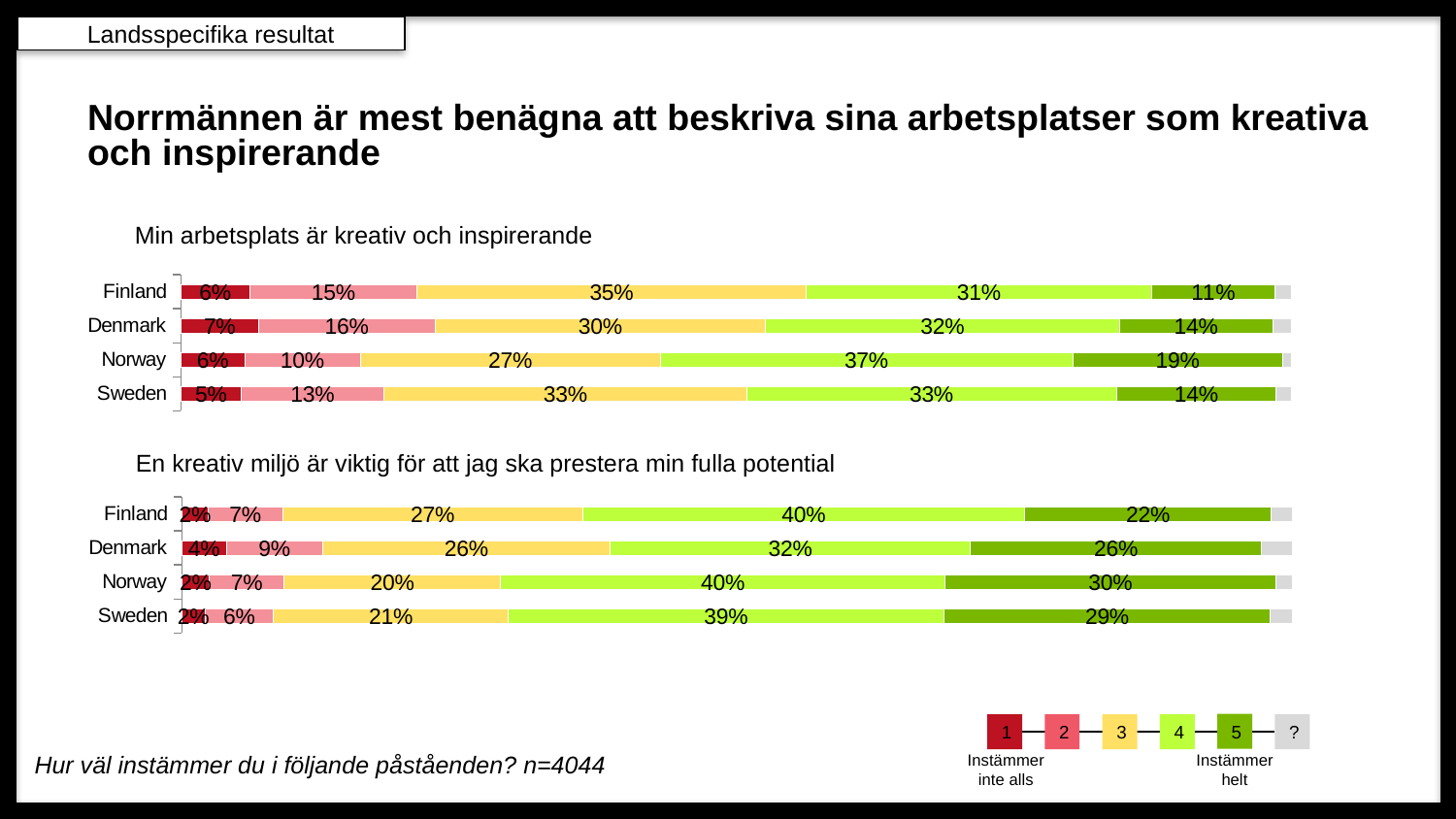
In the chart 'En kreativ miljö är viktig för att jag ska prestera min fulla potential', what is the difference between Sweden's and Denmark's share answering 4? 7% What type of chart is used for 'En kreativ miljö är viktig för att jag ska prestera min fulla potential'? Stacked bar chart In the chart 'Min arbetsplats är kreativ och inspirerande', which country has the lowest share answering 1 (Instämmer inte alls)? Sweden In the chart 'Min arbetsplats är kreativ och inspirerande', which country has the highest share answering 5 (Instämmer helt)? Norway How many countries are shown in the chart 'Min arbetsplats är kreativ och inspirerande'? 4 In the chart 'En kreativ miljö är viktig för att jag ska prestera min fulla potential', is the share answering 3 larger for Finland or Norway? Finland In the chart 'Min arbetsplats är kreativ och inspirerande', what is the difference between Norway's and Finland's share answering 4? 6% How many entries does the legend at the bottom right of the slide list? 6 In the chart 'En kreativ miljö är viktig för att jag ska prestera min fulla potential', what percentage of respondents in Denmark answered 5 (Instämmer helt)? 26% In the chart 'En kreativ miljö är viktig för att jag ska prestera min fulla potential', which country has the highest share answering 5 (Instämmer helt)? Norway In the chart 'Min arbetsplats är kreativ och inspirerande', what percentage of respondents in Norway answered 5 (Instämmer helt)? 19% In the chart 'Min arbetsplats är kreativ och inspirerande', what percentage of respondents in Finland answered 3? 35%